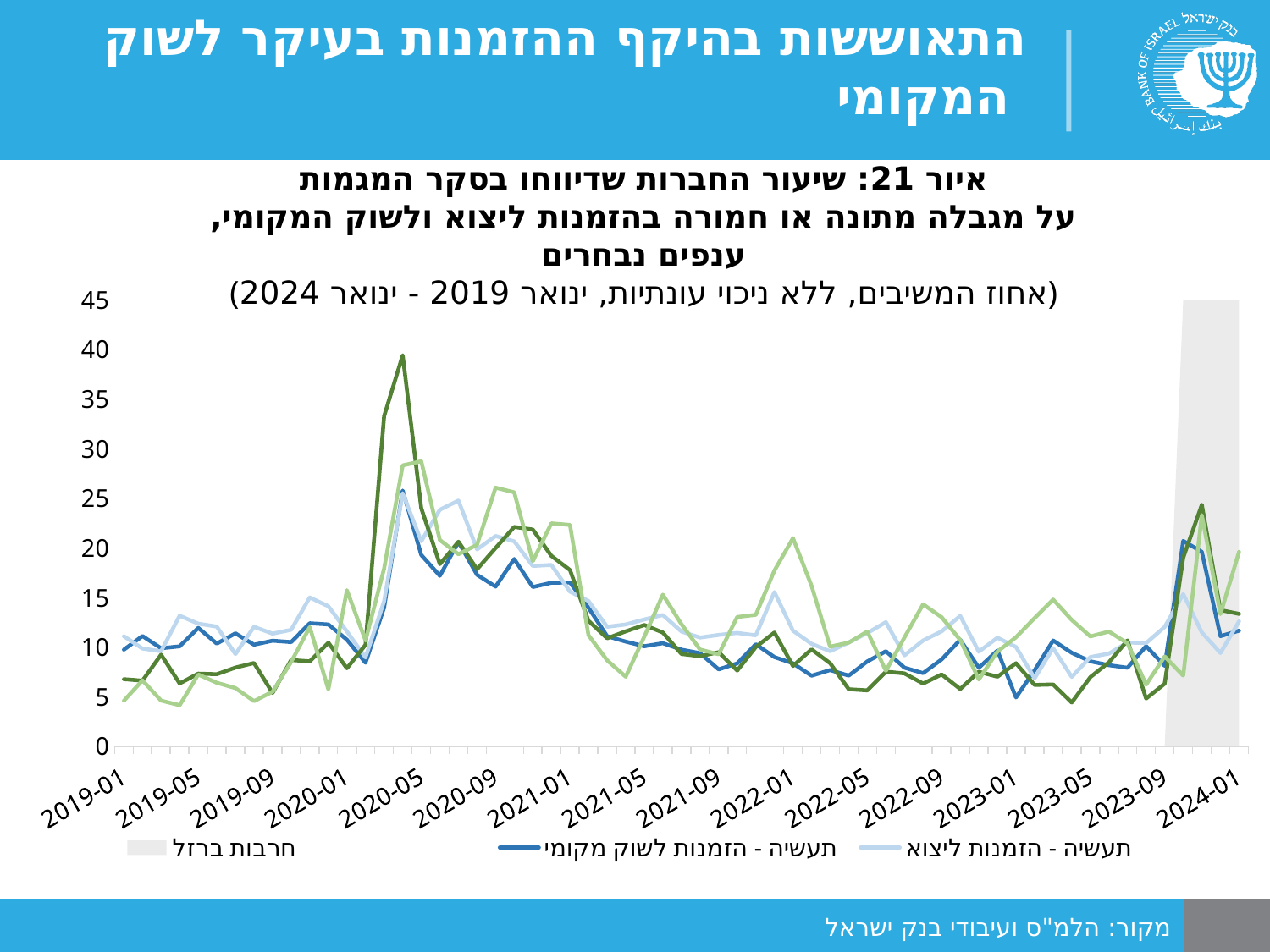
Is the value of the 'תעשיה - הזמנות לשוק מקומי' series at 2022-05 greater or less than 10? less What kind of chart is shown on the slide? line chart What does the grey shaded area at the right of the chart represent, according to the legend? חרבות ברזל Is the value of the 'תעשיה - הזמנות ליצוא' series at 2019-05 greater or less than 10? greater How many date labels are shown along the horizontal axis? 16 What is the highest value shown on the vertical axis? 45 How many entries does the chart legend list? 3 Does the 'תעשיה - הזמנות לשוק מקומי' series rise or fall between 2020-05 and 2021-05? fall In which month does the 'תעשיה - הזמנות לשוק מקומי' series reach its highest value? 2020-04 At 2023-11, which series is higher: 'תעשיה - הזמנות לשוק מקומי' or 'תעשיה - הזמנות ליצוא'? תעשיה - הזמנות לשוק מקומי